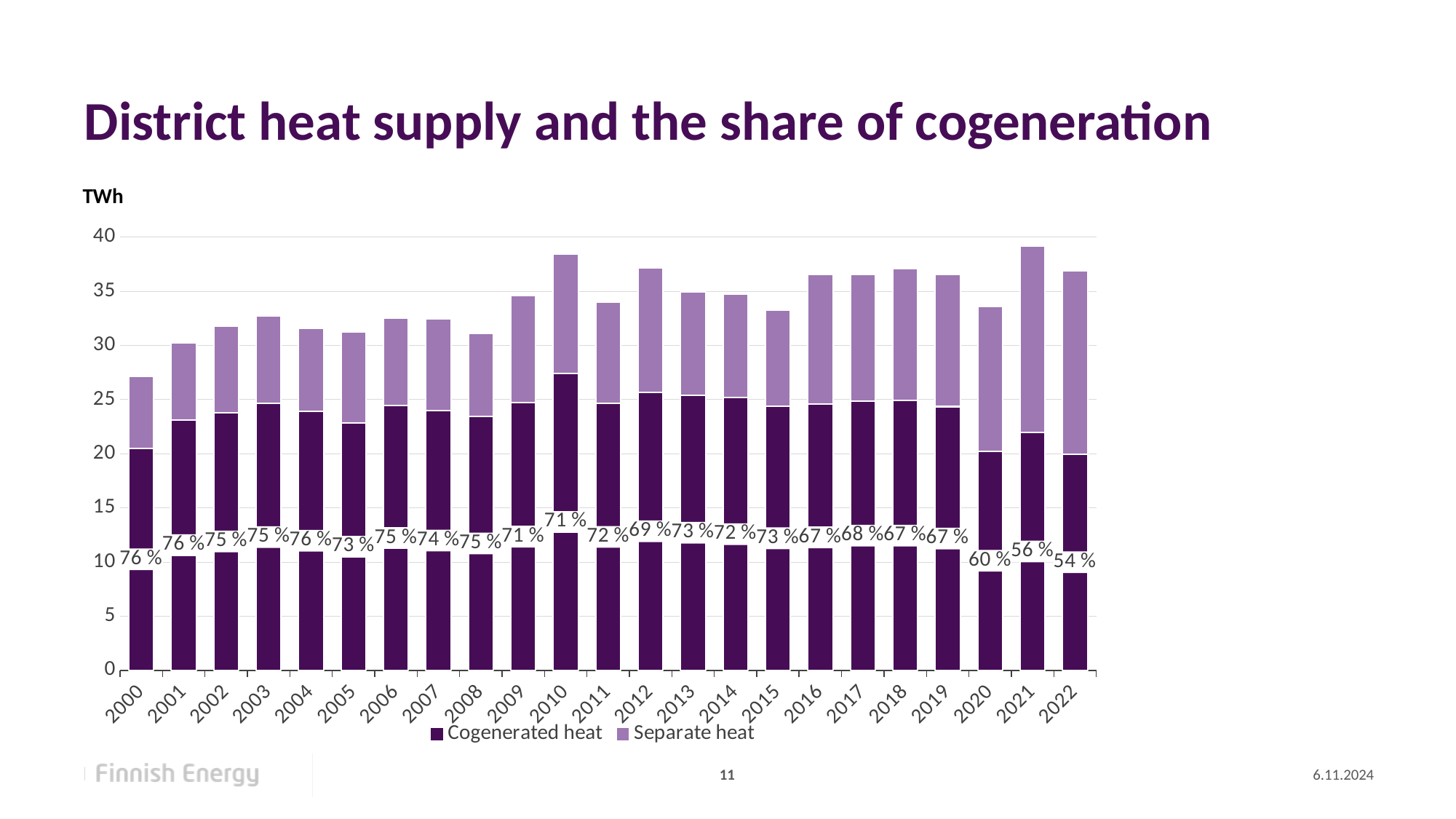
Which year has the lowest total district heat supply? 2000 Is the total district heat supply for 2021 greater or less than 35 TWh? greater Do the labelled cogeneration shares generally rise or fall from 2000 to 2022? fall What share of cogeneration is labelled for 2022? 54 % Which year has the lowest labelled share of cogeneration? 2022 What share of cogeneration is labelled for 2020? 60 % What share of cogeneration is labelled for 2010? 71 % How many years are shown on the x axis? 23 What is the difference in percentage points between the cogeneration share labelled for 2000 and for 2022? 22 How many series does the legend list? 2 Is the total district heat supply for 2000 greater or less than 30 TWh? less What kind of chart is shown on the slide? Stacked bar chart